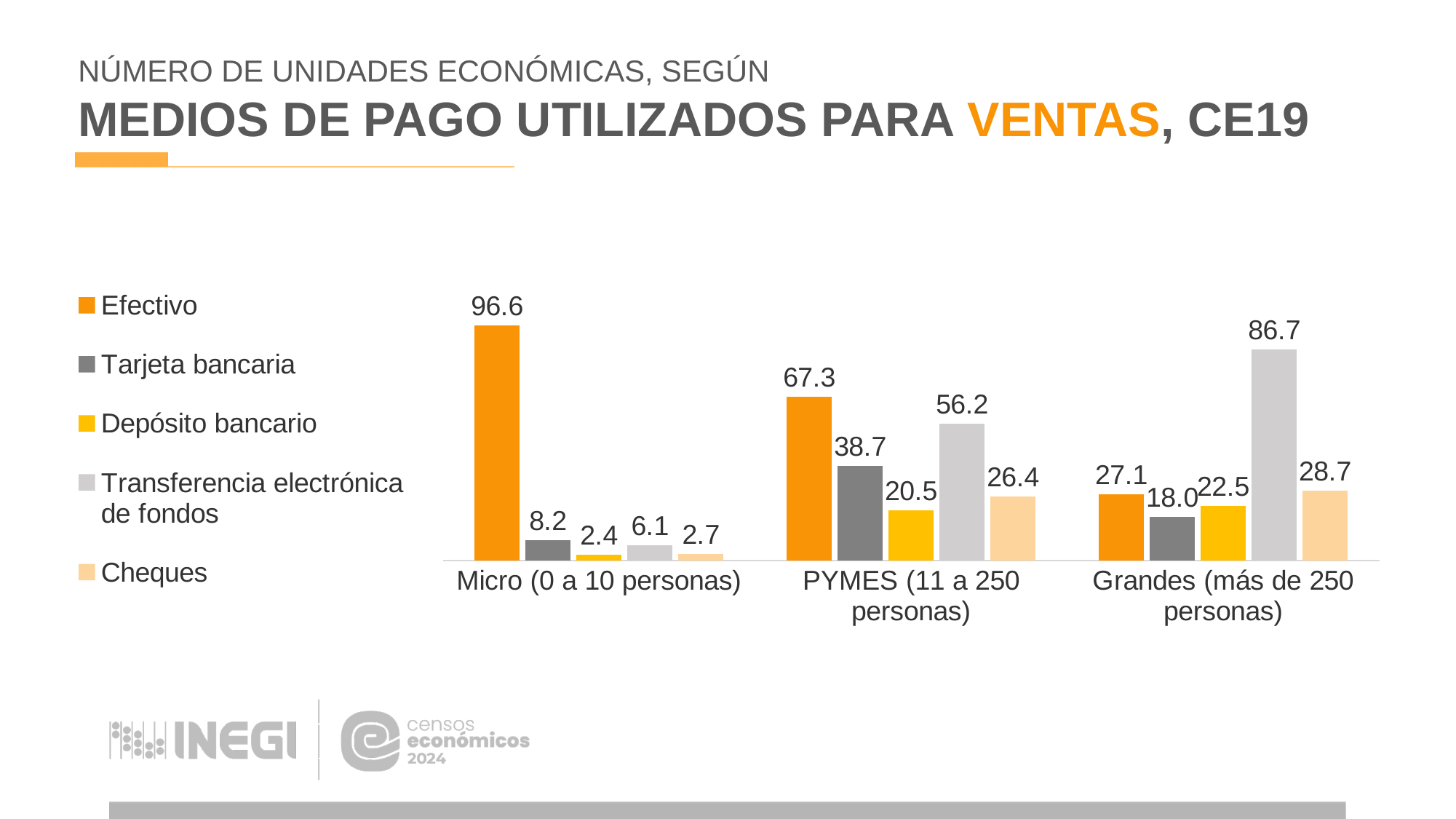
What is the value for Efectivo in the Micro (0 a 10 personas) category? 96.6 What is the difference between Efectivo and Transferencia electrónica de fondos in the PYMES (11 a 250 personas) category? 11.1 How does the value for Efectivo change from Micro to PYMES to Grandes? It falls What is the value for Tarjeta bancaria in the PYMES (11 a 250 personas) category? 38.7 What kind of chart is shown on the slide? Bar chart What is the value for Cheques in the Micro (0 a 10 personas) category? 2.7 Which payment method has the highest value in the Grandes (más de 250 personas) category? Transferencia electrónica de fondos How many series does the legend list? 5 Which is larger in the Grandes (más de 250 personas) category: Cheques or Efectivo? Cheques What is the value for Transferencia electrónica de fondos in the Grandes (más de 250 personas) category? 86.7 How many size categories are shown on the x axis? 3 Which payment method has the lowest value in the Micro (0 a 10 personas) category? Depósito bancario